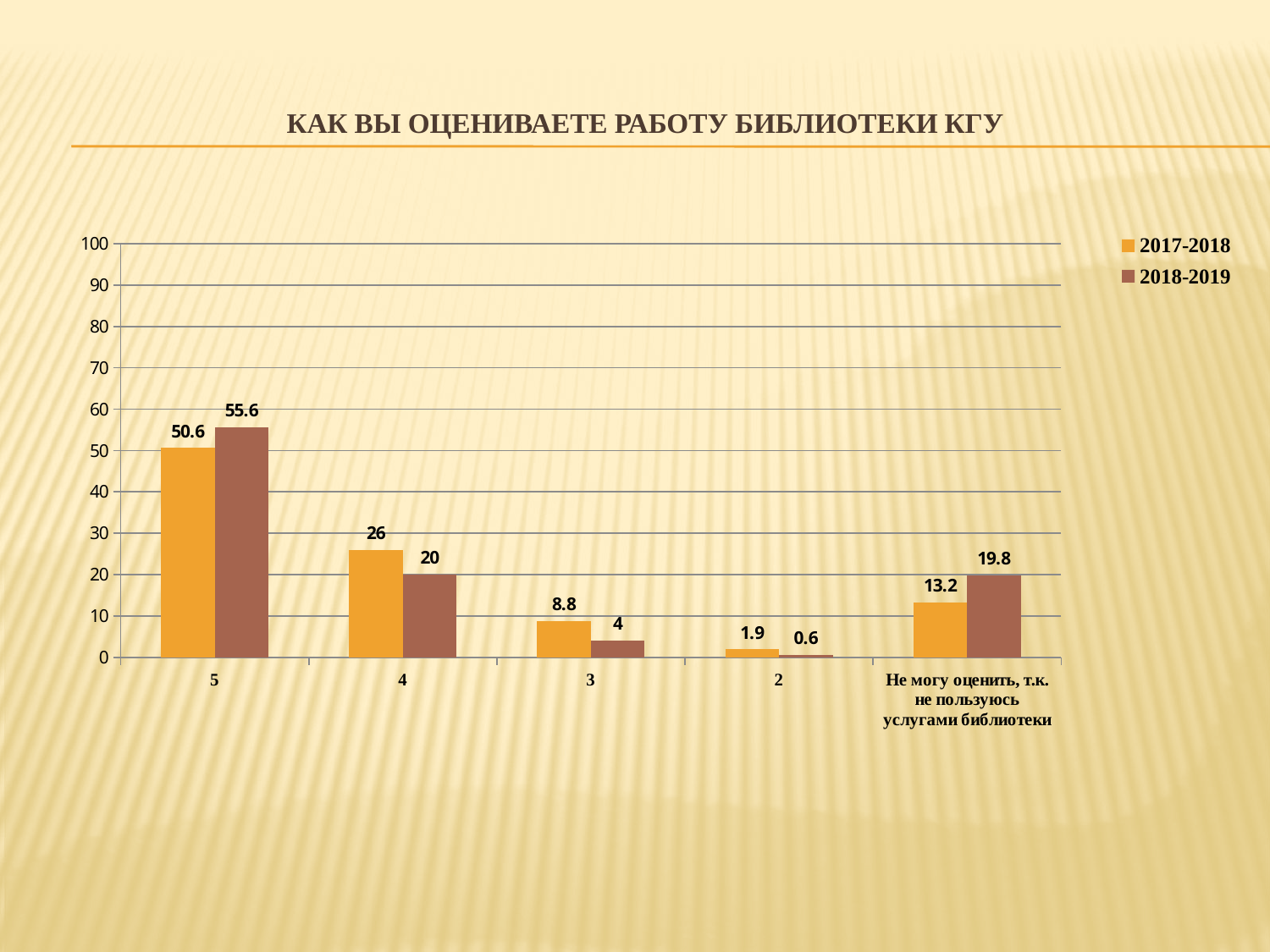
Which category has the lowest value in the 2017-2018 series? 2 How many categories are shown on the x axis? 5 What is the value for category 5 in the 2017-2018 series? 50.6 How many series does the legend list? 2 What is the difference between the 2017-2018 and 2018-2019 values for category 3? 4.8 What is the value for category 4 in the 2018-2019 series? 20 What kind of chart is shown on the slide? bar chart What is the 2018-2019 value for the category 'Не могу оценить, т.к. не пользуюсь услугами библиотеки'? 19.8 What is the title of the chart? КАК ВЫ ОЦЕНИВАЕТЕ РАБОТУ БИБЛИОТЕКИ КГУ For category 4, which series has the larger value, 2017-2018 or 2018-2019? 2017-2018 What is the difference between the 2018-2019 and 2017-2018 values for category 5? 5 Which category has the highest value in the 2018-2019 series? 5